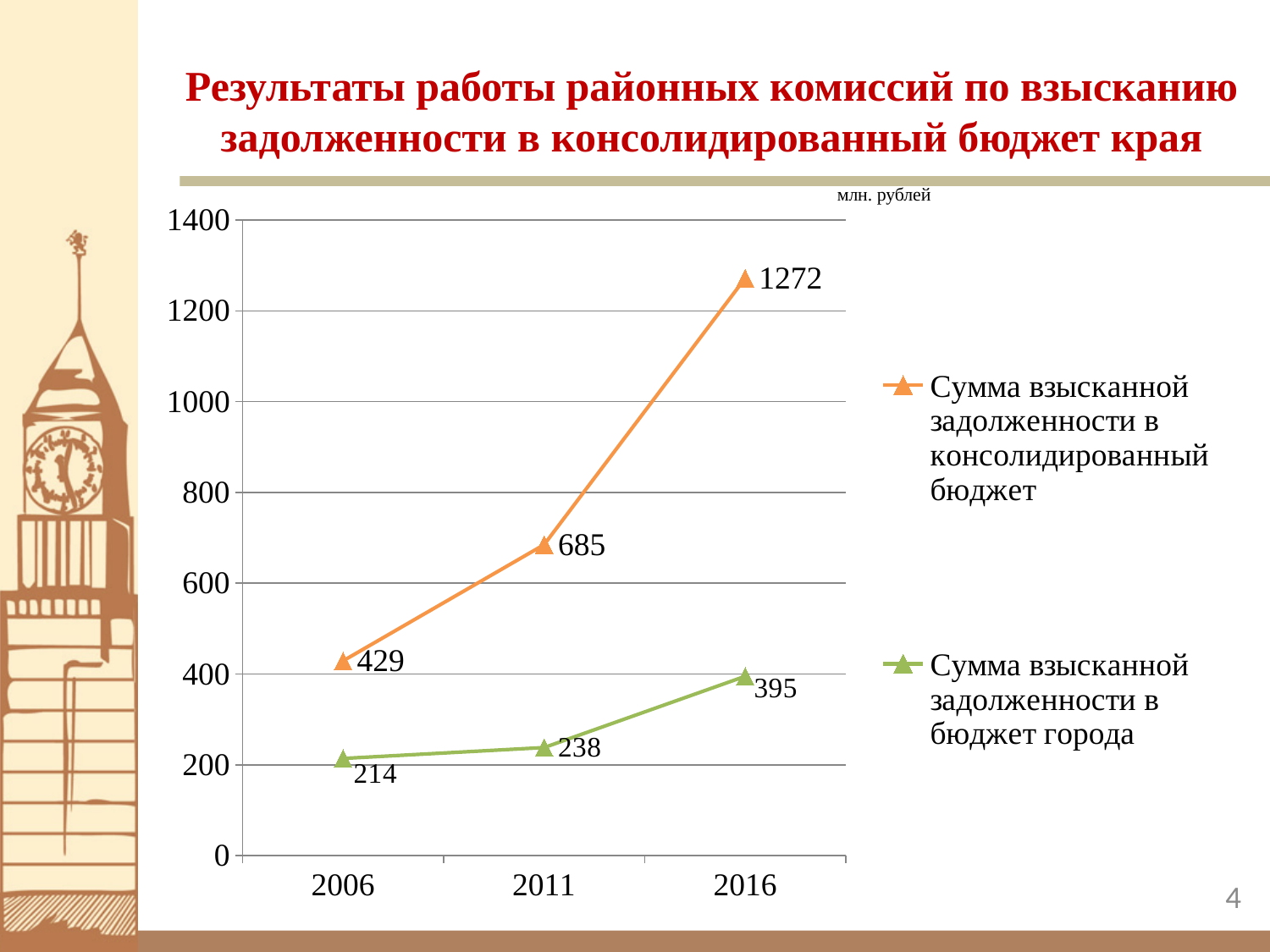
In which year is 'Сумма взысканной задолженности в бюджет города' the lowest? 2006 How many years are shown on the x axis? 3 In which year is 'Сумма взысканной задолженности в консолидированный бюджет' the highest? 2016 What is the difference between 'Сумма взысканной задолженности в консолидированный бюджет' in 2016 and in 2011? 587 What is the value of 'Сумма взысканной задолженности в бюджет города' in 2006? 214 Which series has the larger value in 2011? Сумма взысканной задолженности в консолидированный бюджет What is the value of 'Сумма взысканной задолженности в консолидированный бюджет' in 2011? 685 What is the value of 'Сумма взысканной задолженности в консолидированный бюджет' in 2016? 1272 How many series does the legend list? 2 What is the difference between the two series in 2006? 215 What is the value of 'Сумма взысканной задолженности в бюджет города' in 2016? 395 What type of chart is shown on the slide? line chart